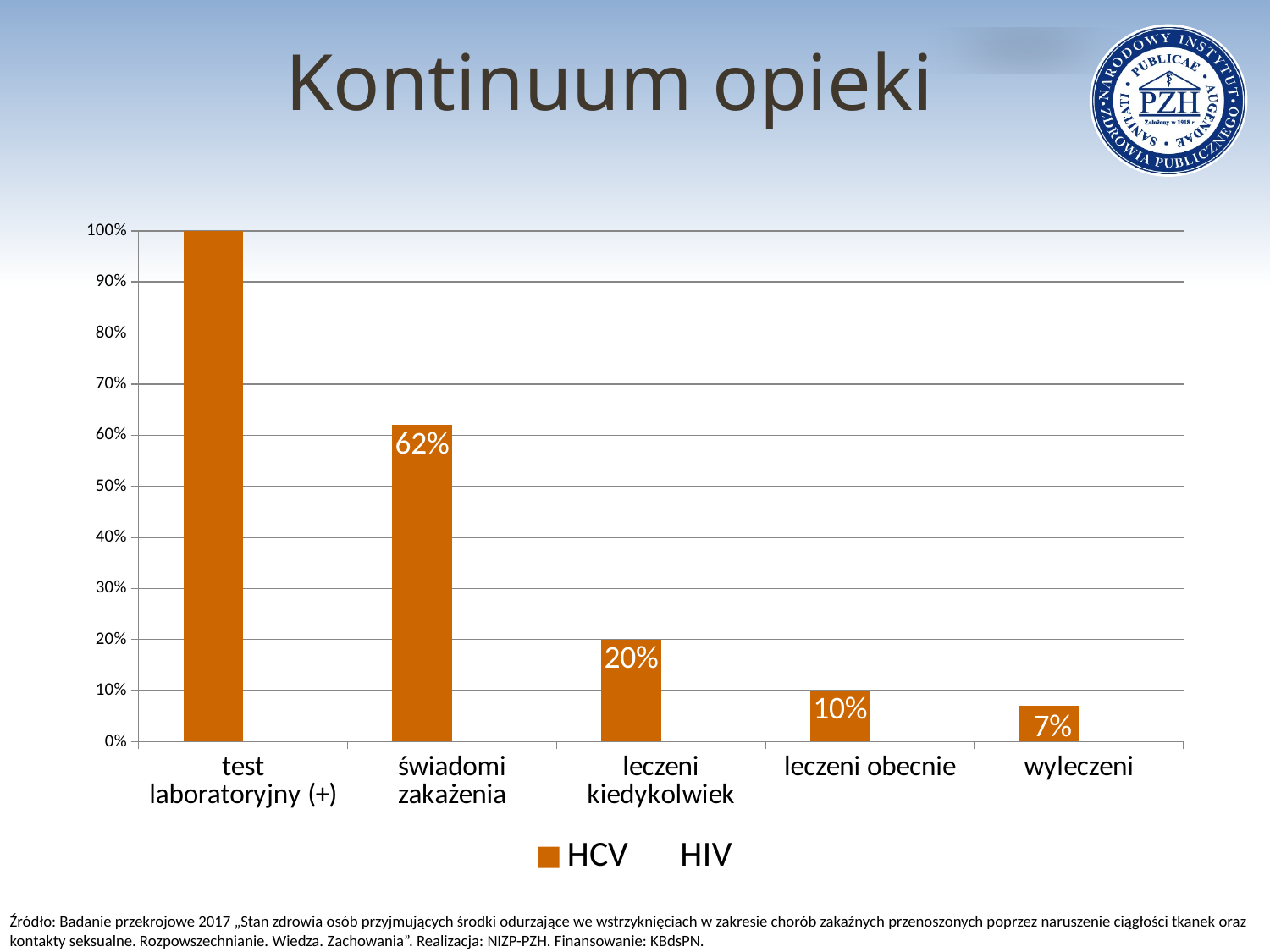
What kind of chart is shown on the slide? bar chart Is the HCV value for test laboratoryjny (+) greater or less than 90%? greater Which is larger, the HCV value for leczeni obecnie or for wyleczeni? leczeni obecnie Which category has the highest HCV value? test laboratoryjny (+) Which category has the lowest HCV value? wyleczeni What is the HCV value for leczeni obecnie? 10% What is the difference between the HCV values for świadomi zakażenia and leczeni kiedykolwiek? 42% What is the HCV value for świadomi zakażenia? 62% How many series does the legend list? 2 What is the HCV value for wyleczeni? 7% How many categories are shown on the x axis? 5 What is the HCV value for leczeni kiedykolwiek? 20%